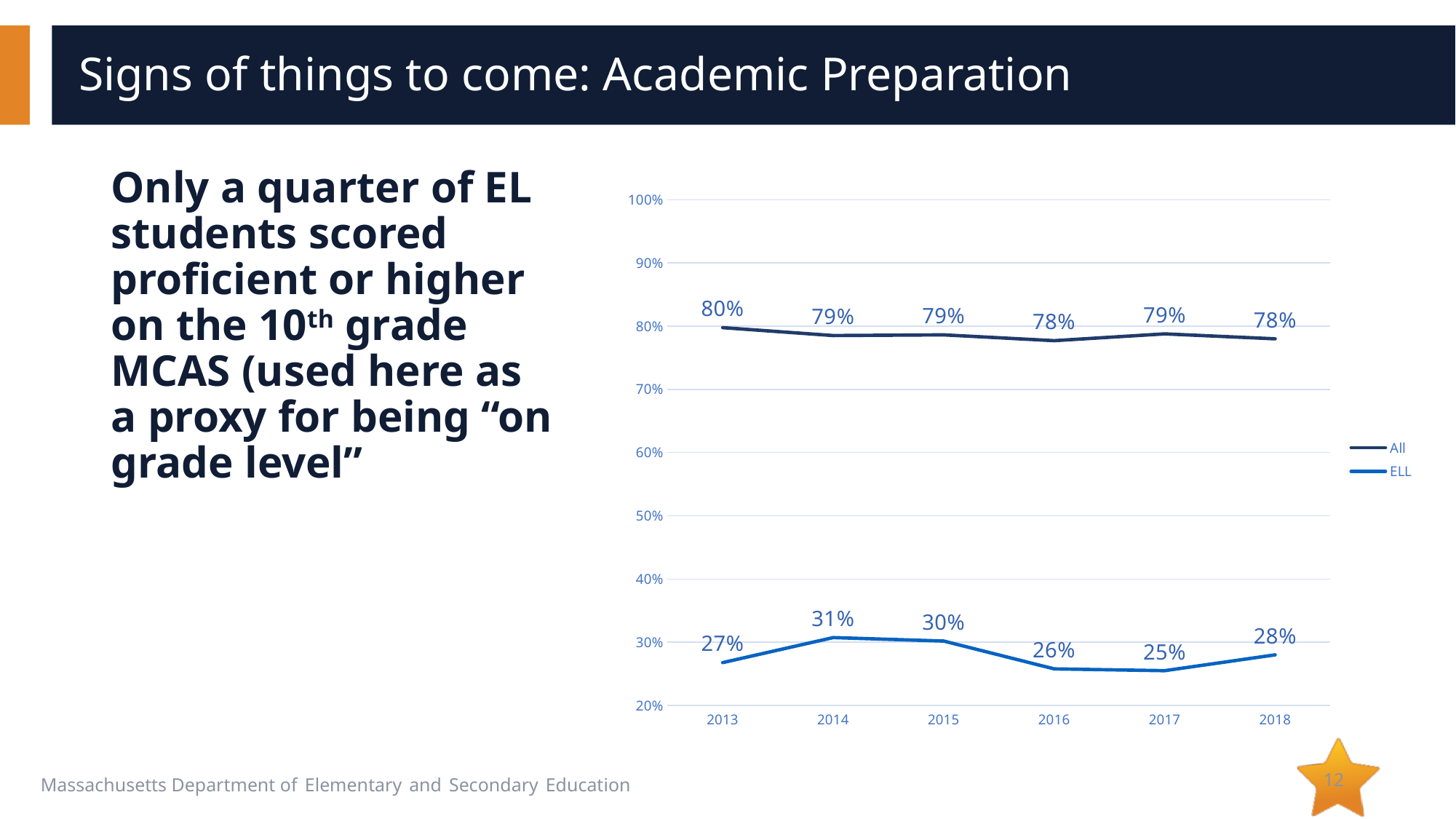
How many series does the legend list? 2 What are the two series listed in the legend? All and ELL What is the value for All in 2013? 80% What kind of chart is shown on the slide? line chart Does the All series rise or fall from 2013 to 2018? fall In which year is the ELL value lowest? 2017 What is the value for ELL in 2017? 25% In which year is the ELL value highest? 2014 How many years are shown on the x axis? 6 Which is larger, the ELL value in 2015 or the ELL value in 2016? 2015 What is the difference between the All and ELL values in 2018? 50% What is the value for ELL in 2014? 31%